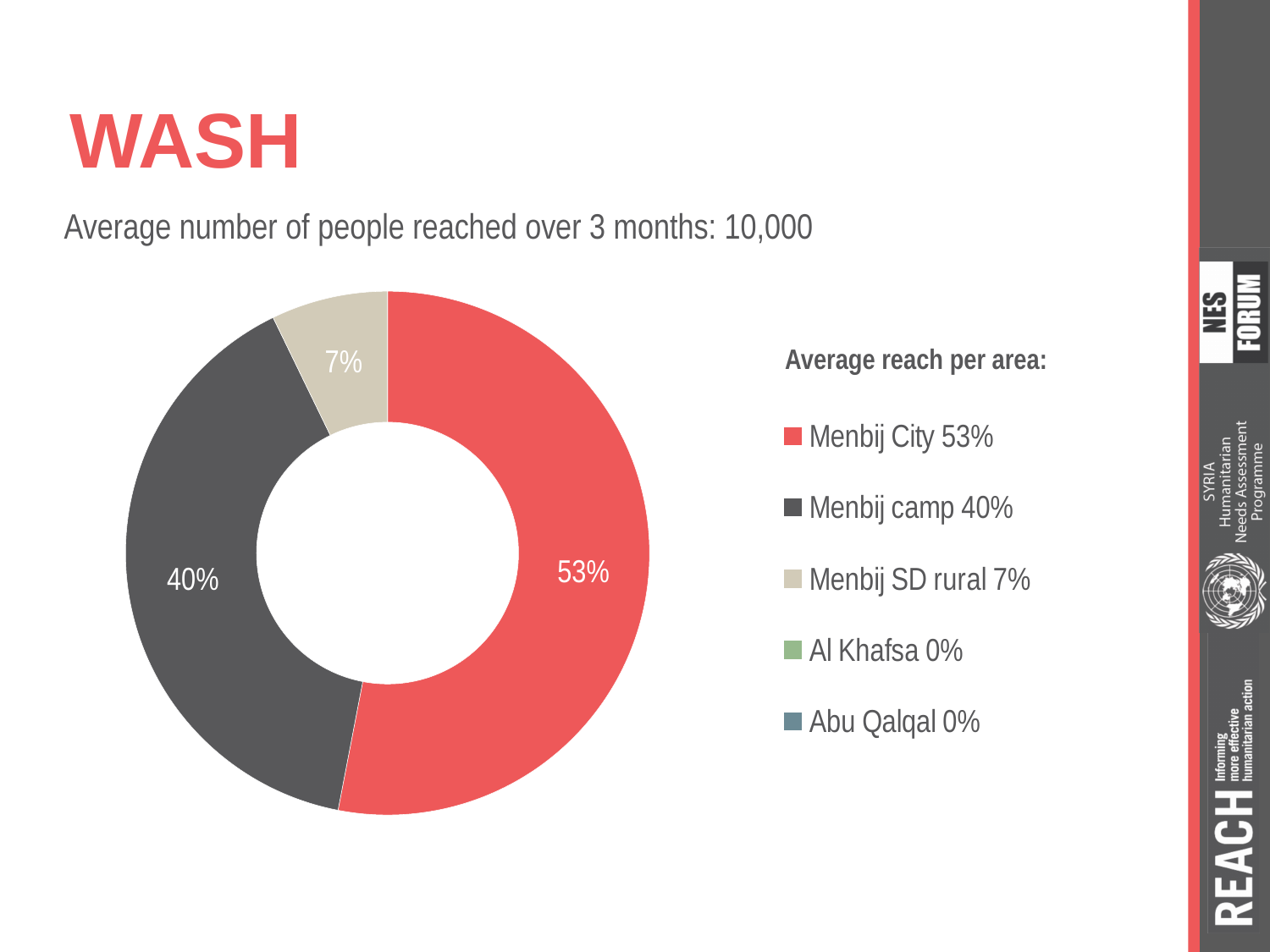
Which area has the smallest non-zero share of the average reach? Menbij SD rural Which is larger, the share for Menbij camp or the share for Menbij SD rural? Menbij camp What share of the average reach is for Menbij camp? 40% What is the average number of people reached over 3 months stated on the slide? 10,000 How many areas are listed in the legend? 5 Which area has the largest share of the average reach? Menbij City What share of the average reach is for Menbij City? 53% What is the difference in percentage points between Menbij City and Menbij camp? 13 percentage points What kind of chart is shown on the slide? Doughnut (pie) chart What share of the average reach is for Menbij SD rural? 7% How many areas have a share of 0%? 2 What share of the average reach is for Al Khafsa? 0%